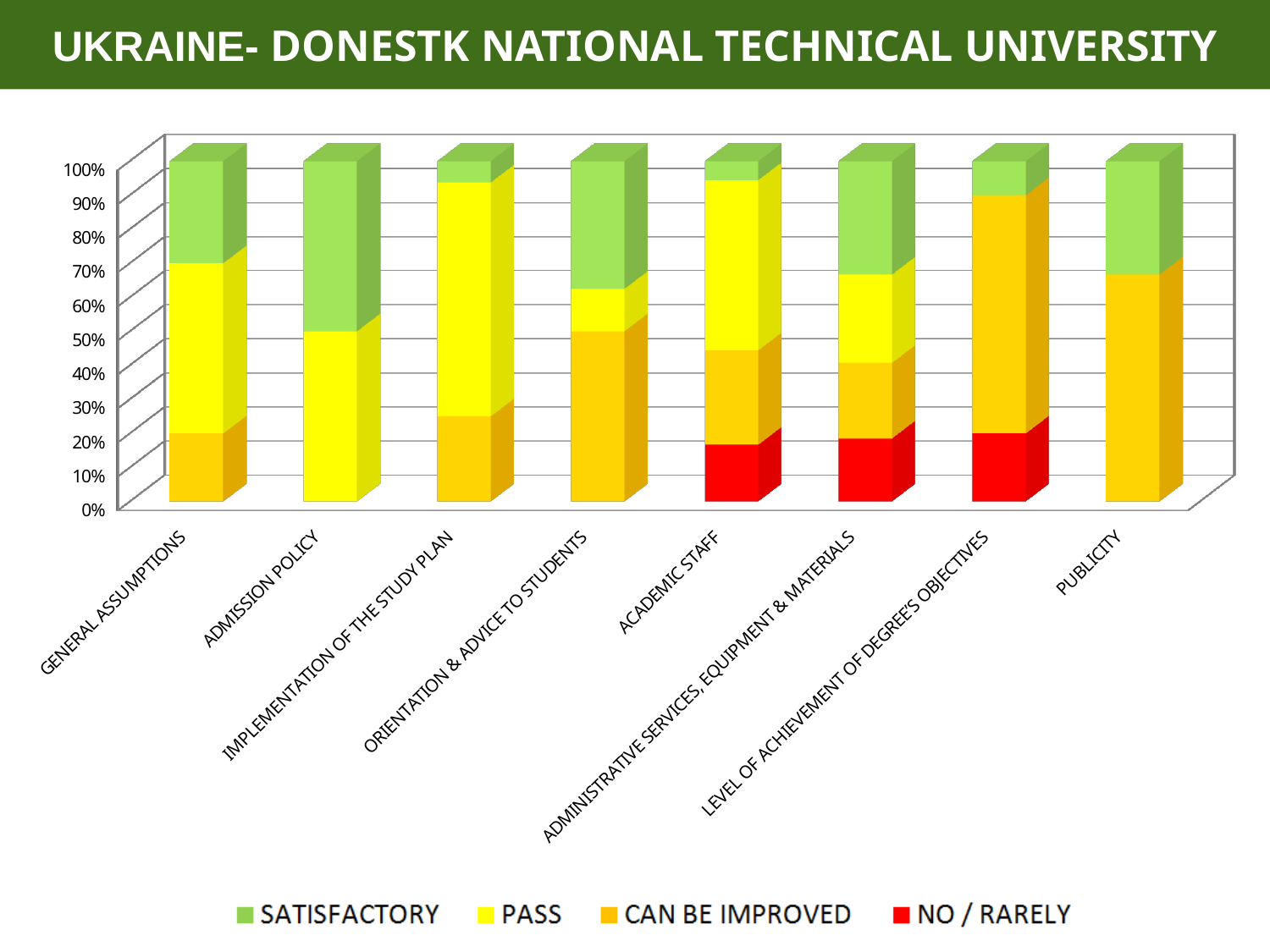
How many categories are shown along the x axis of the chart? 8 Is the CAN BE IMPROVED share for PUBLICITY greater or less than 50%? greater Is the CAN BE IMPROVED share for GENERAL ASSUMPTIONS greater or less than 30%? less Is the NO / RARELY share for ACADEMIC STAFF greater or less than 30%? less Which category has the largest SATISFACTORY share? ADMISSION POLICY Which category has the largest PASS share? IMPLEMENTATION OF THE STUDY PLAN How many series does the chart legend list? 4 Which series is shown in red in the chart legend? NO / RARELY What kind of chart is shown on the slide? Stacked bar chart Which has the larger SATISFACTORY share, ADMISSION POLICY or IMPLEMENTATION OF THE STUDY PLAN? ADMISSION POLICY How many categories include a NO / RARELY (red) segment? 3 What is the title shown above the chart? UKRAINE- DONESTK NATIONAL TECHNICAL UNIVERSITY